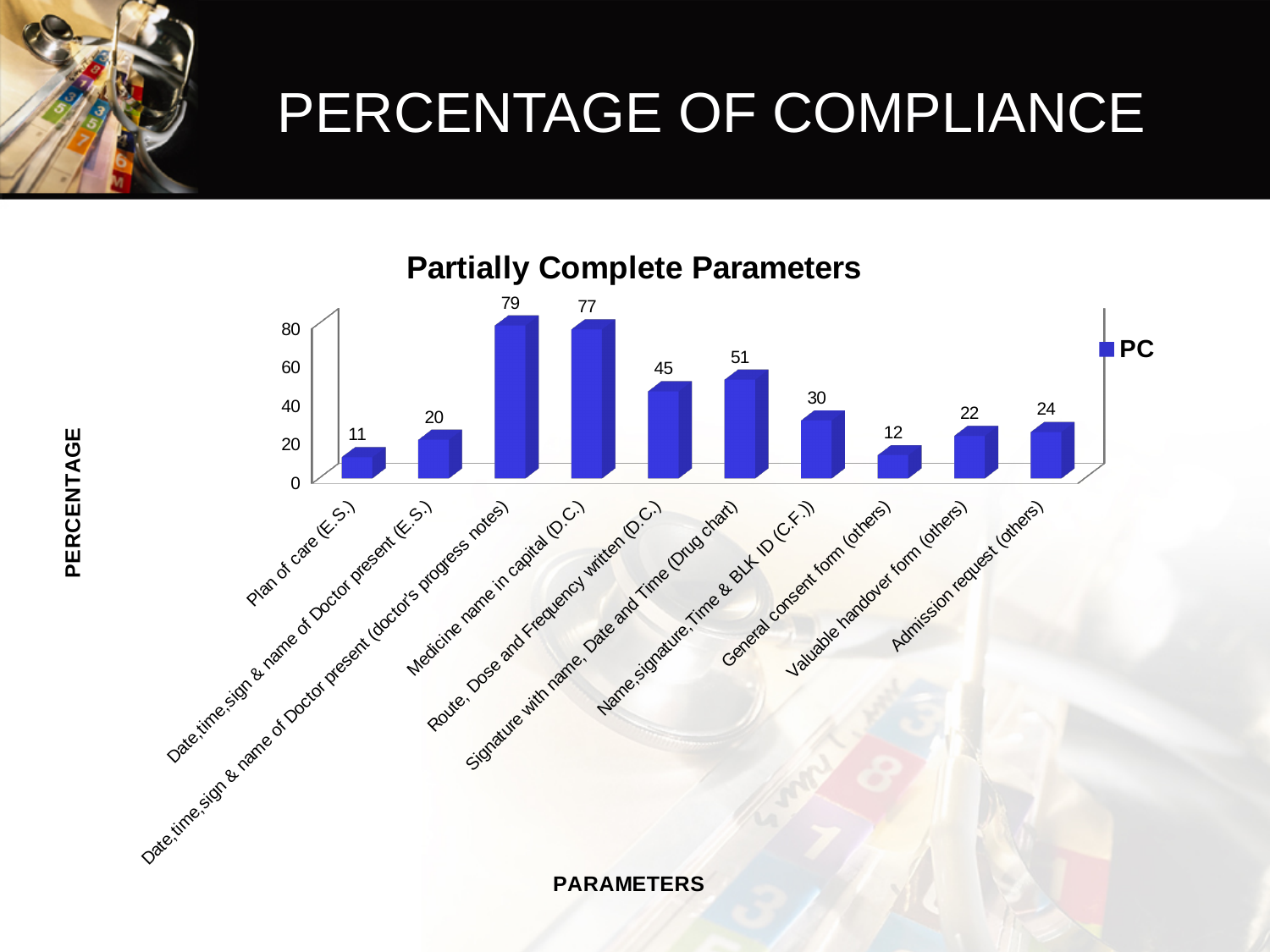
What kind of chart is shown? bar chart What is the difference between the values for Route, Dose and Frequency written (D.C.) and Name,signature,Time & BLK ID (C.F.)? 15 What is the value for Medicine name in capital (D.C.)? 77 How many series does the legend list? 1 Which is larger, the value for Valuable handover form (others) or Admission request (others)? Admission request (others) What is the value for Plan of care (E.S.)? 11 What is the value for General consent form (others)? 12 Which parameter has the lowest value? Plan of care (E.S.) How many parameters are shown on the x axis? 10 Is the value for Route, Dose and Frequency written (D.C.) greater or less than 40? greater What is the value for Signature with name, Date and Time (Drug chart)? 51 Which parameter has the highest value? Date,time,sign & name of Doctor present (doctor's progress notes)